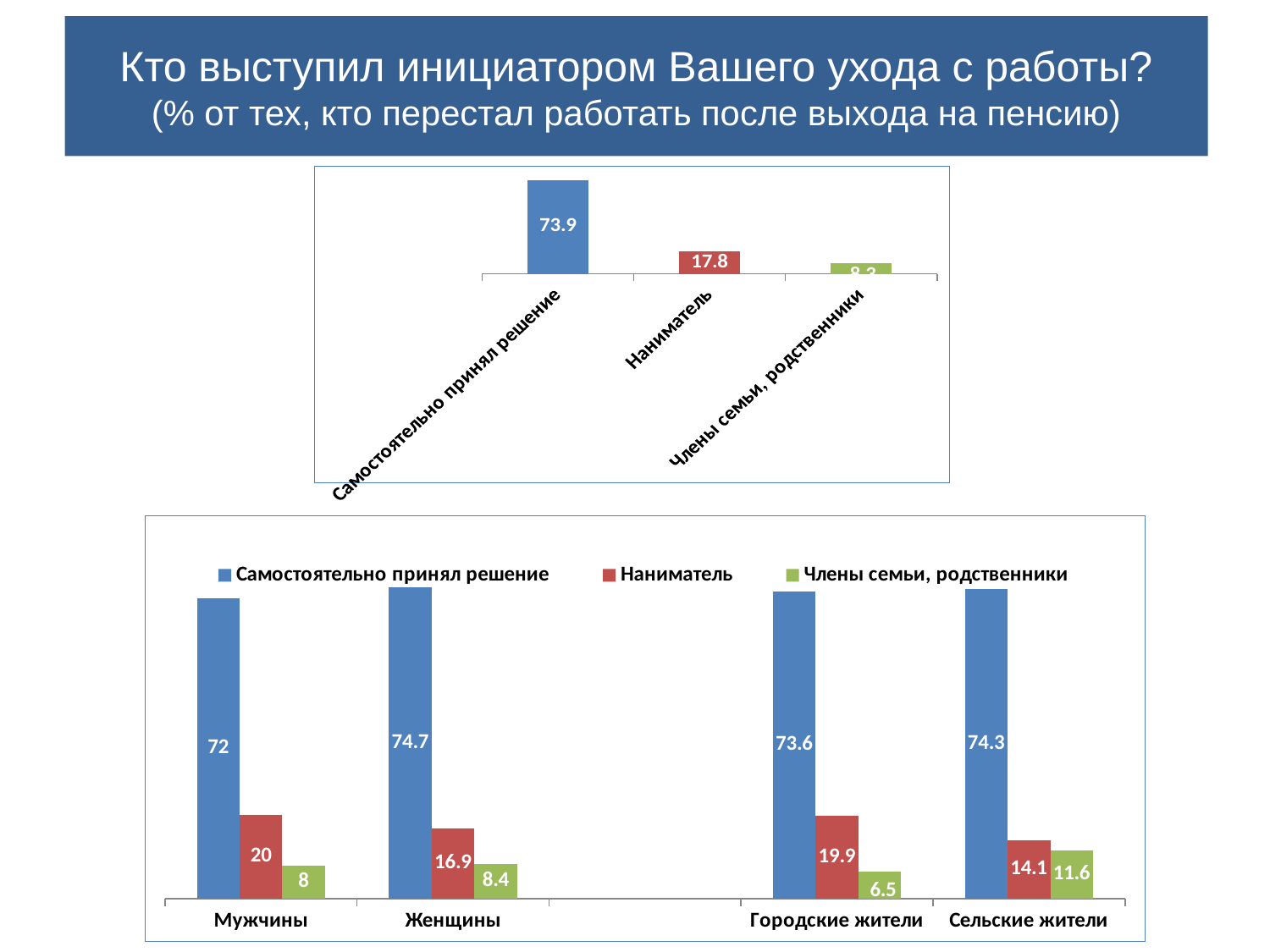
In the top chart, what is the value for Наниматель? 17.8 What type of chart is the bottom chart? Bar chart In the top chart, what is the value for Самостоятельно принял решение? 73.9 In the bottom chart, what is the difference between the Наниматель values for Мужчины and Женщины? 3.1 In the bottom chart, how many series does the legend list? 3 In the top chart, how many categories are shown? 3 In the bottom chart, what is the value for Самостоятельно принял решение among Сельские жители? 74.3 In the bottom chart, what is the value for Наниматель among Мужчины? 20 In the bottom chart, which is larger: Члены семьи, родственники for Сельские жители or for Городские жители? Сельские жители In the bottom chart, which group has the highest value for Самостоятельно принял решение? Женщины In the bottom chart, what is the value for Члены семьи, родственники among Городские жители? 6.5 In the top chart, which category has the highest value? Самостоятельно принял решение